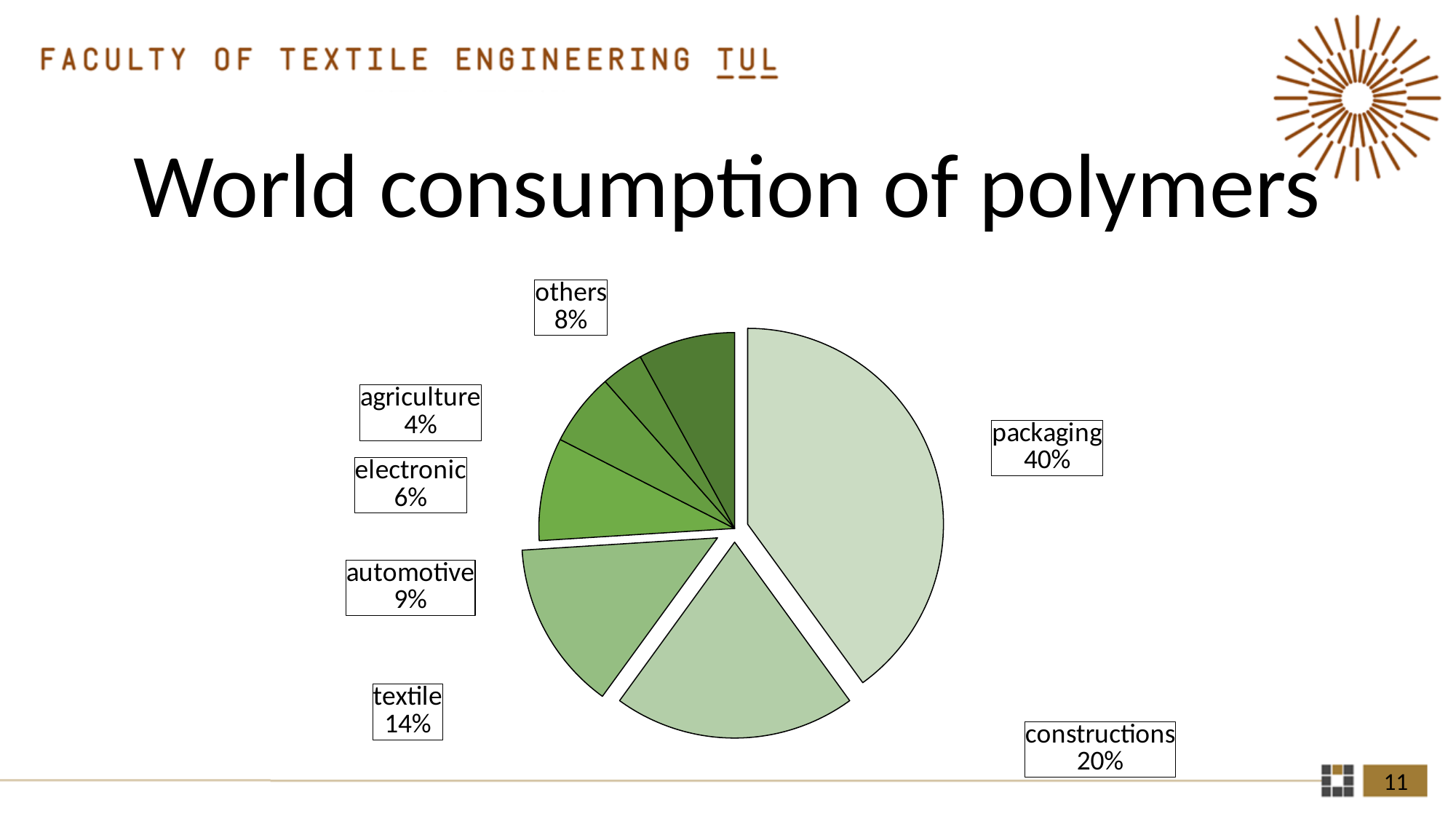
What percentage is shown for textile? 14% What share of world polymer consumption is packaging? 40% Which category has the largest slice of the pie? packaging What is the combined share of textile and automotive? 23% What percentage is shown for agriculture? 4% What is the title of the slide containing the chart? World consumption of polymers Which category has the smallest slice of the pie? agriculture What kind of chart is shown on the slide? pie chart What percentage is shown for constructions? 20% Which is larger, the share for automotive or the share for electronic? automotive What is the difference in percentage points between packaging and constructions? 20 How many categories are shown in the pie chart? 7